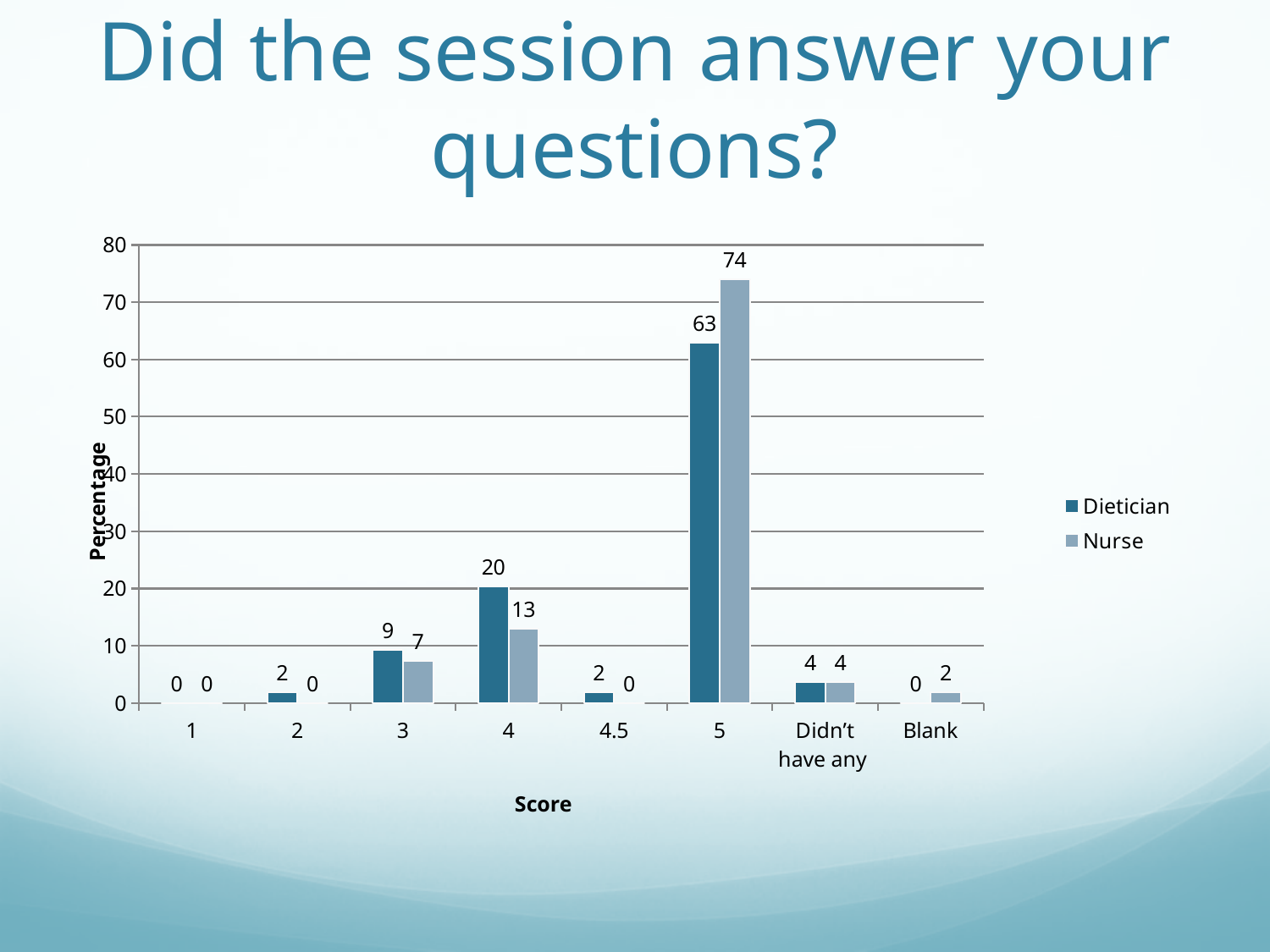
What kind of chart is shown on the slide? Bar chart What is the difference between the Dietician and Nurse values for score 4? 7 For score 3, which series has the larger value, Dietician or Nurse? Dietician How many categories are shown on the x axis? 8 What is the Nurse value for score 3? 7 Which score category has the highest Nurse value? 5 What is the Nurse value for score 5? 74 What is the Dietician value for score 5? 63 What is the Nurse value for Blank? 2 How many series does the legend list? 2 What is the Dietician value for score 4? 20 What is the difference between the Nurse and Dietician values for score 5? 11